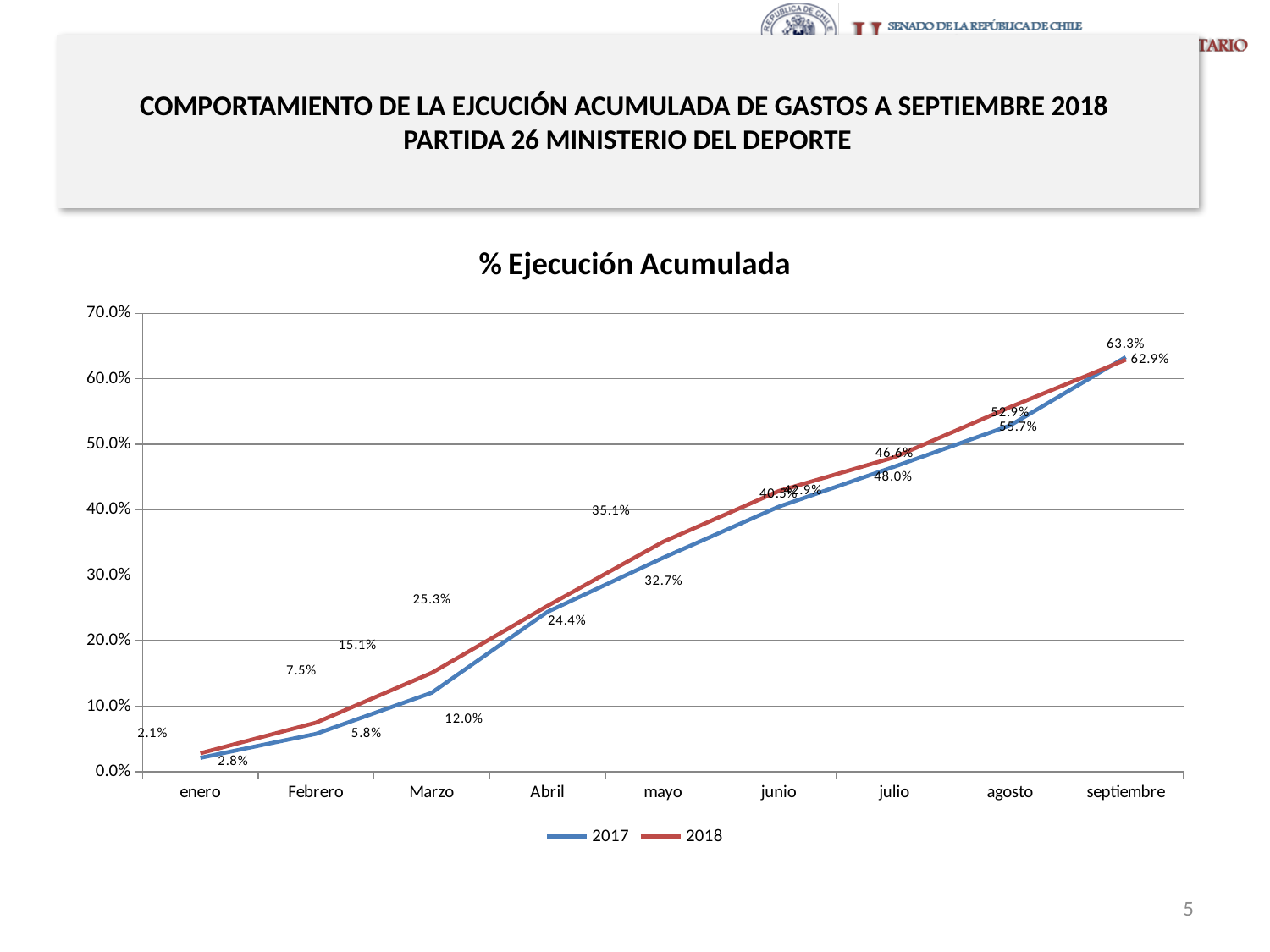
What type of chart is shown on the slide? line chart Do the values rise or fall from enero to septiembre? rise What is the highest value labeled on the chart? 63.3% What two values are labeled at Abril? 25.3% and 24.4% Is the value for 2017 at Marzo greater or less than 20.0%? less Is the value for 2018 at septiembre greater or less than 60.0%? greater How many series does the legend list? 2 What is the title of the chart? % Ejecución Acumulada What are the two series named in the legend? 2017 and 2018 How many months are shown on the x axis? 9 What is the difference between the two values labeled at septiembre? 0.4% At mayo, which series has the higher value, 2017 or 2018? 2018